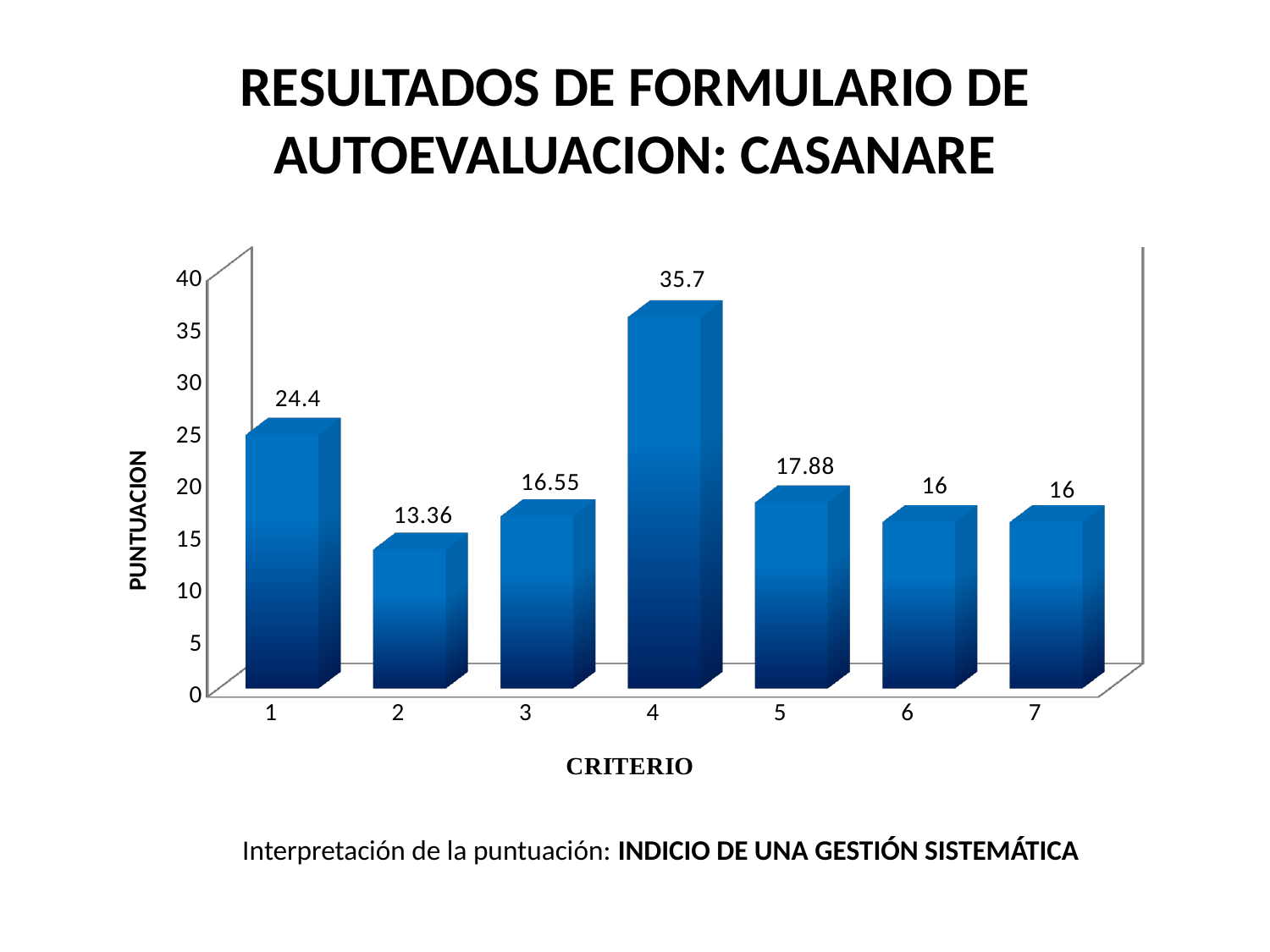
What kind of chart is shown on the slide? Bar chart What is the label of the vertical axis? PUNTUACION What is the PUNTUACION value for CRITERIO 2? 13.36 Which CRITERIO has the highest PUNTUACION? 4 Is the PUNTUACION for CRITERIO 4 greater or less than 30? greater Which CRITERIO has the lowest PUNTUACION? 2 What is the PUNTUACION value for CRITERIO 5? 17.88 How many CRITERIO categories are shown on the chart? 7 What is the PUNTUACION value for CRITERIO 4? 35.7 What is the difference between the PUNTUACION for CRITERIO 4 and CRITERIO 1? 11.3 What is the difference between the PUNTUACION for CRITERIO 3 and CRITERIO 2? 3.19 Which has a larger PUNTUACION, CRITERIO 1 or CRITERIO 5? CRITERIO 1